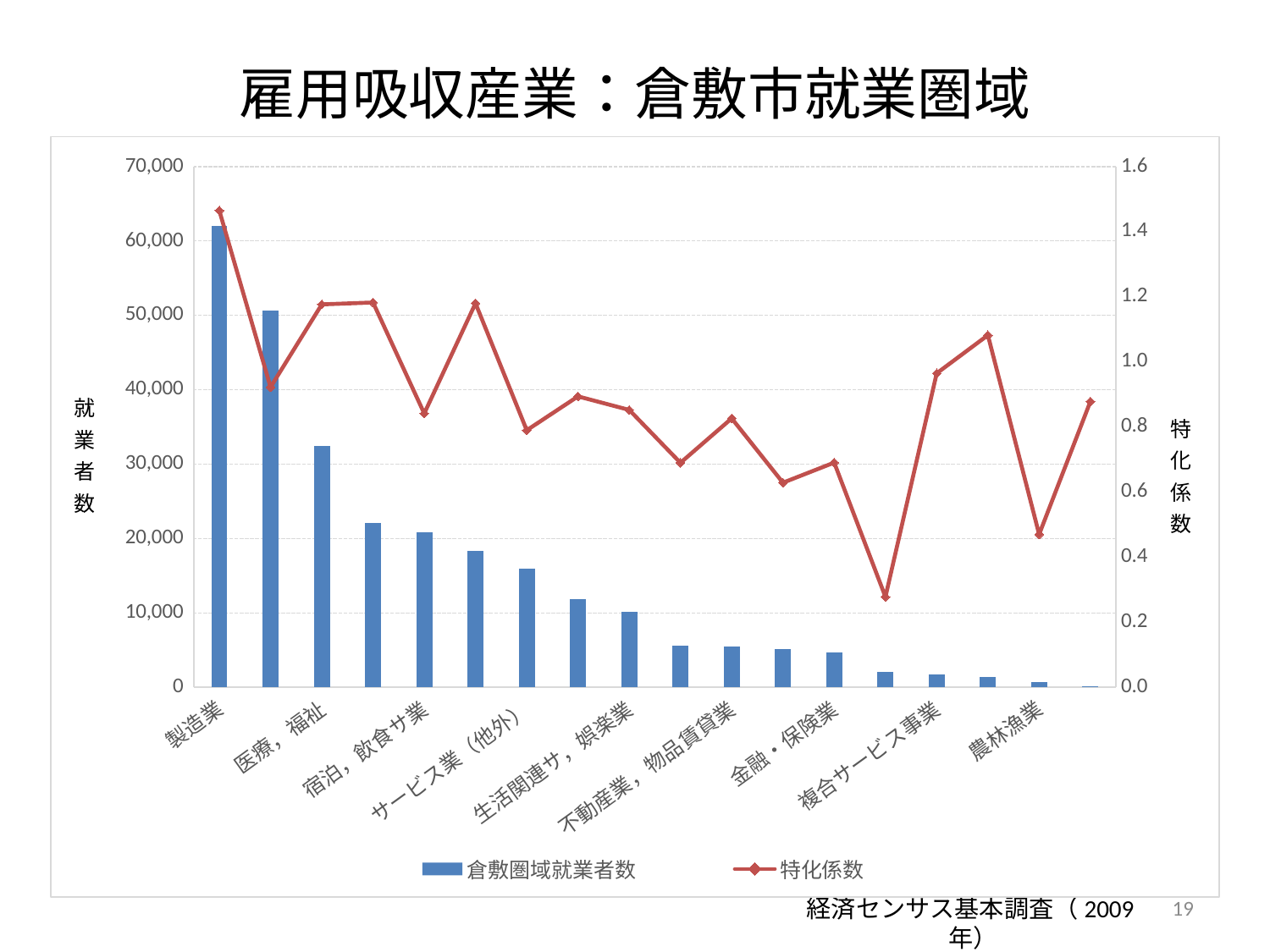
Is the 特化係数 value for 複合サービス事業 greater or less than 0.4? greater How many series does the legend list? 2 Is the 倉敷圏域就業者数 bar for 製造業 greater or less than 50,000? greater Which has the larger 倉敷圏域就業者数, 製造業 or 医療，福祉? 製造業 What is the title of the chart? 雇用吸収産業：倉敷市就業圏域 Which industry has the highest 倉敷圏域就業者数 (tallest bar)? 製造業 Is the 倉敷圏域就業者数 bar for 金融・保険業 greater or less than 10,000? less What kind of chart is shown on the slide? A combined bar and line chart What are the two series named in the legend? 倉敷圏域就業者数 and 特化係数 Do the 倉敷圏域就業者数 bars rise or fall moving from left to right along the x axis? fall